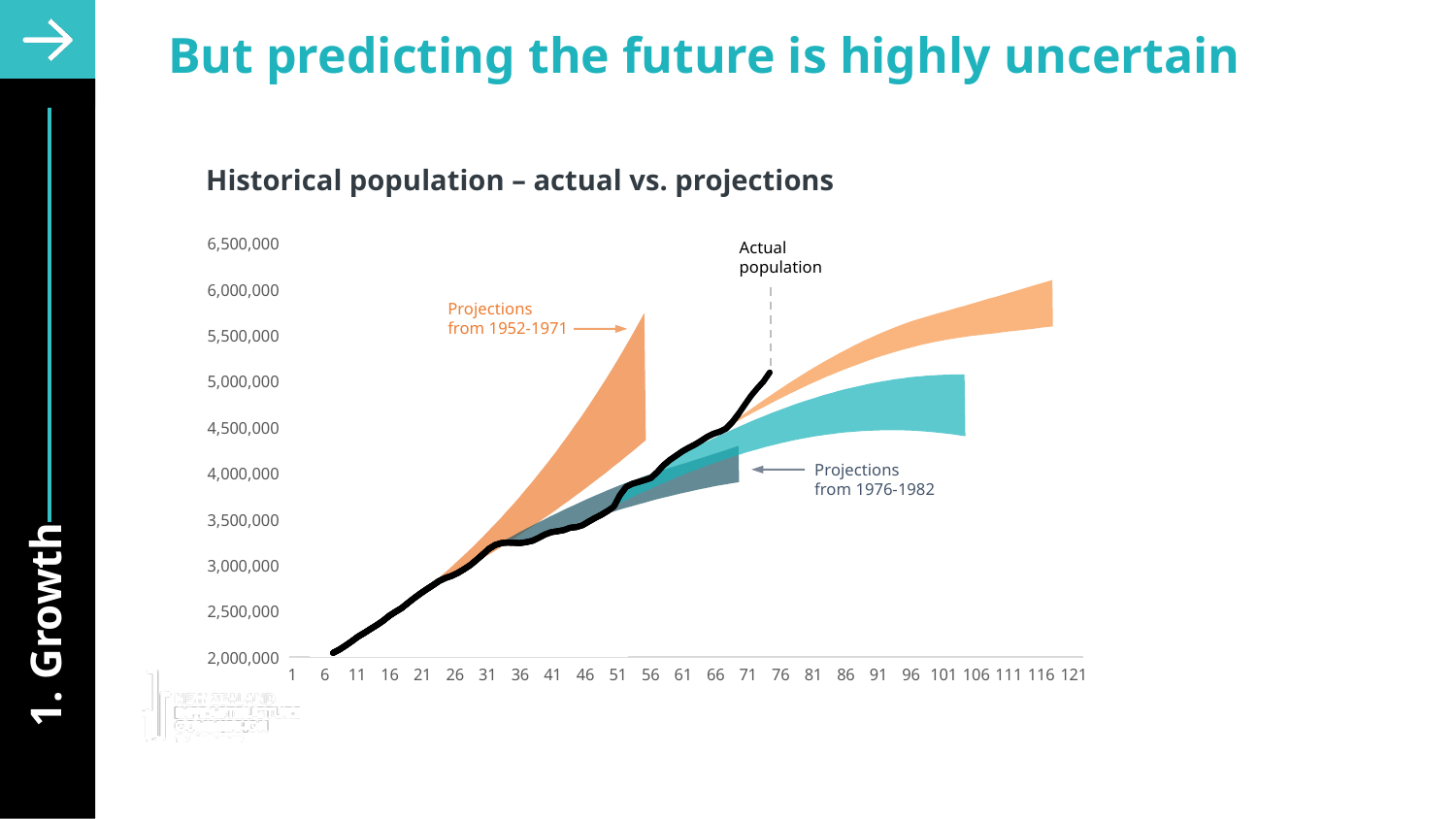
Does the actual population line rise or fall along the x axis? rise Is the actual population at x = 31 greater or less than 3,500,000? less Is the top of the 'Projections from 1952-1971' band at its highest point (around x = 56) greater or less than 5,000,000? greater At x = 56, which is higher: the 'Projections from 1952-1971' band or the actual population line? Projections from 1952-1971 What kind of chart is shown on the slide? combination area and line chart What is the title of the chart on the slide? Historical population – actual vs. projections Which projection band reaches higher values: 'Projections from 1952-1971' or 'Projections from 1976-1982'? Projections from 1952-1971 Is the actual population at the end of the black line (around x = 75) greater or less than 4,500,000? greater What is the last label shown on the x axis of the chart? 121 What is the highest value shown on the y axis of the chart? 6,500,000